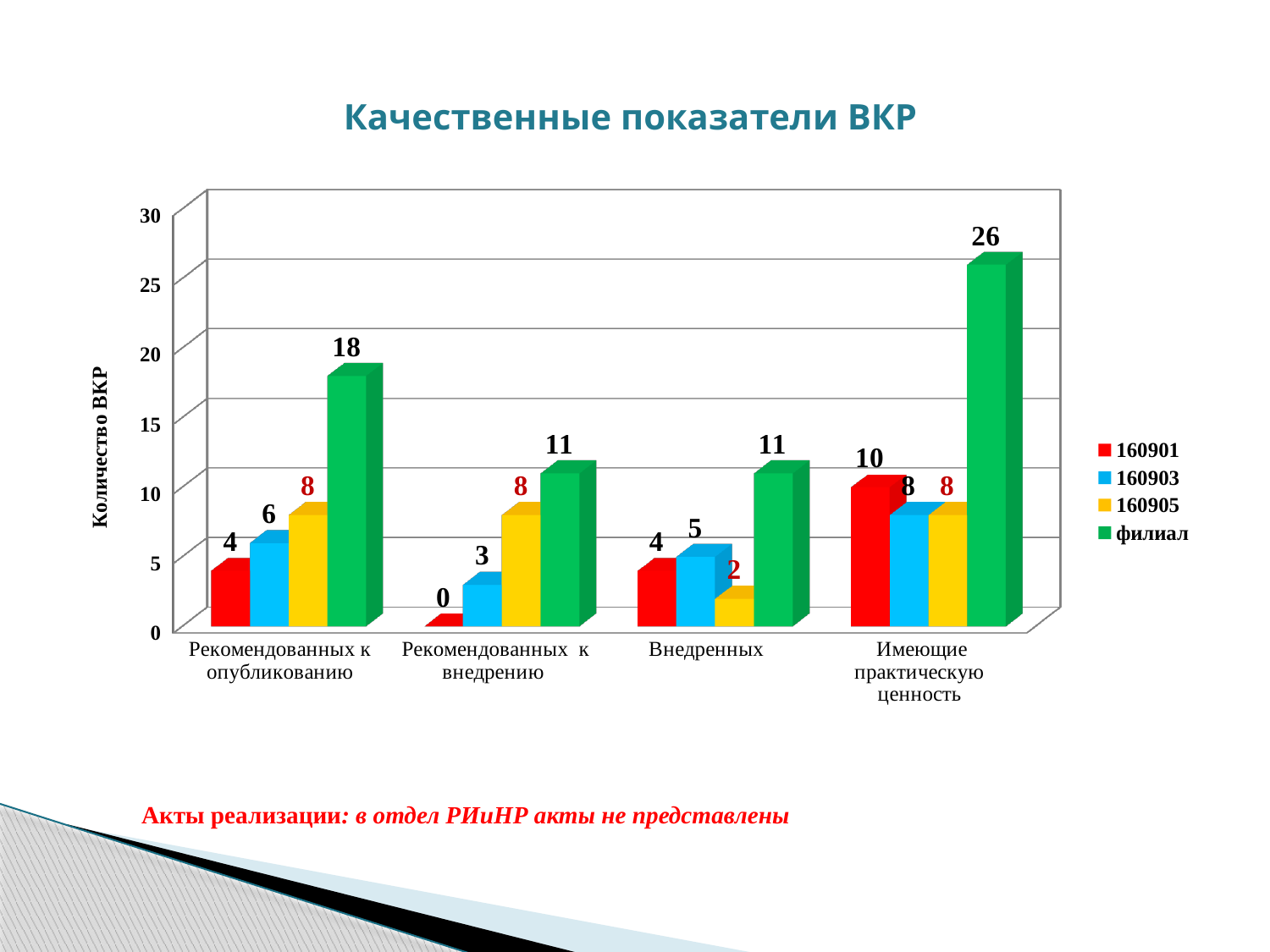
What type of chart is shown on the slide? bar chart What is the value for филиал in the category Имеющие практическую ценность? 26 In which category does филиал have its highest value? Имеющие практическую ценность What is the difference between the филиал value and the 160901 value in the category Рекомендованных к опубликованию? 14 What is the title of the chart? Качественные показатели ВКР How many categories are shown on the x axis? 4 How many series does the legend list? 4 What is the value for 160905 in the category Внедренных? 2 In which category does 160901 have its lowest value? Рекомендованных к внедрению What is the value for 160903 in the category Рекомендованных к опубликованию? 6 What is the value for 160901 in the category Рекомендованных к внедрению? 0 Which is larger in the category Внедренных: the value for 160903 or the value for 160905? 160903